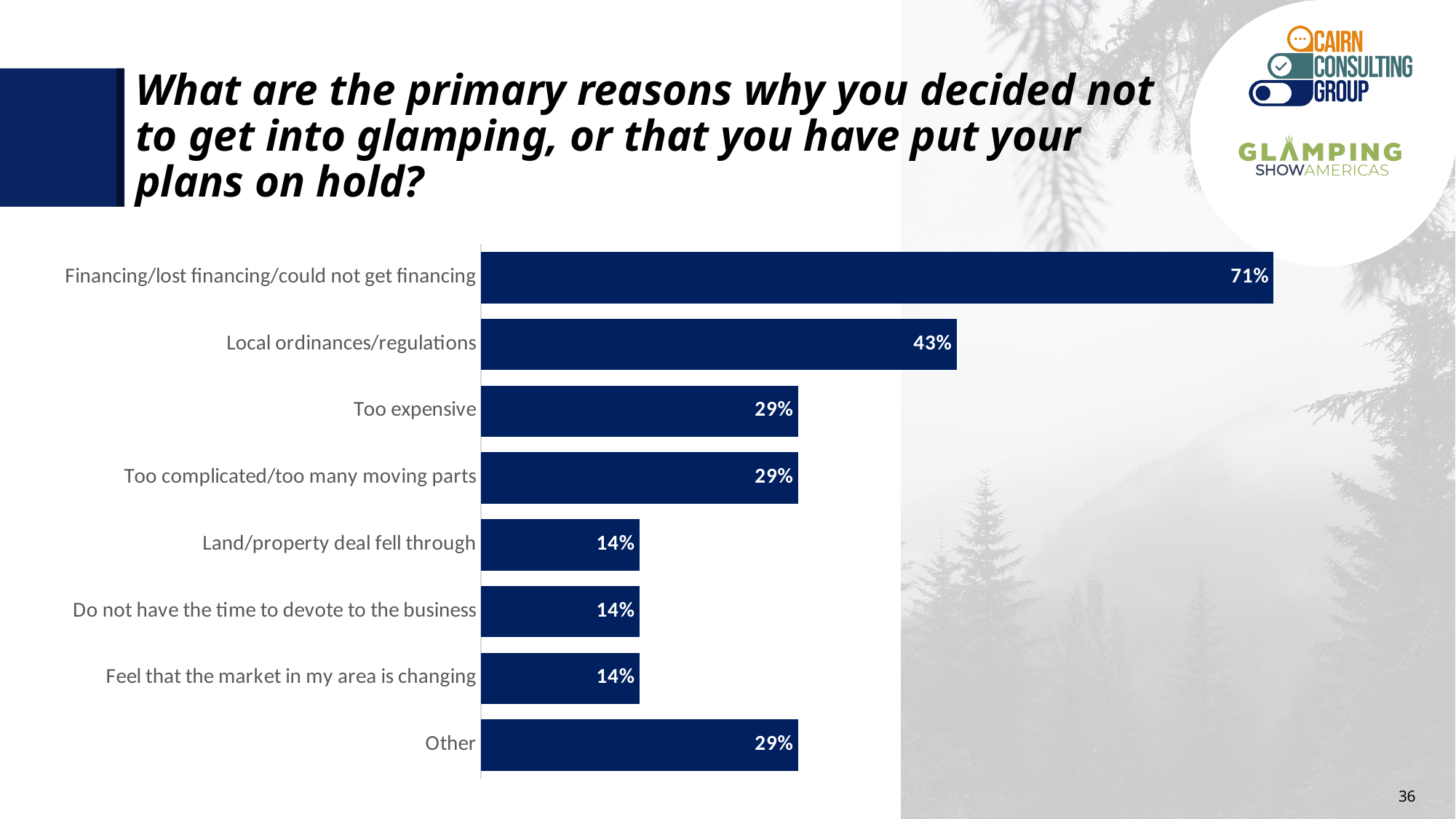
What colour are the bars in the chart? Dark blue What percentage is shown for Land/property deal fell through? 14% What is the difference between Too expensive and Land/property deal fell through? 15 percentage points What percentage of respondents cited Financing/lost financing/could not get financing as a reason? 71% How many reasons (categories) are shown in the chart? 8 What is the value for Other? 29% What kind of chart is shown on the slide? Bar chart Which is larger, Local ordinances/regulations or Too complicated/too many moving parts? Local ordinances/regulations How many categories share the lowest value of 14%? 3 Which reason has the highest percentage? Financing/lost financing/could not get financing What is the difference between Financing/lost financing/could not get financing and Local ordinances/regulations? 28 percentage points What is the value for Local ordinances/regulations? 43%